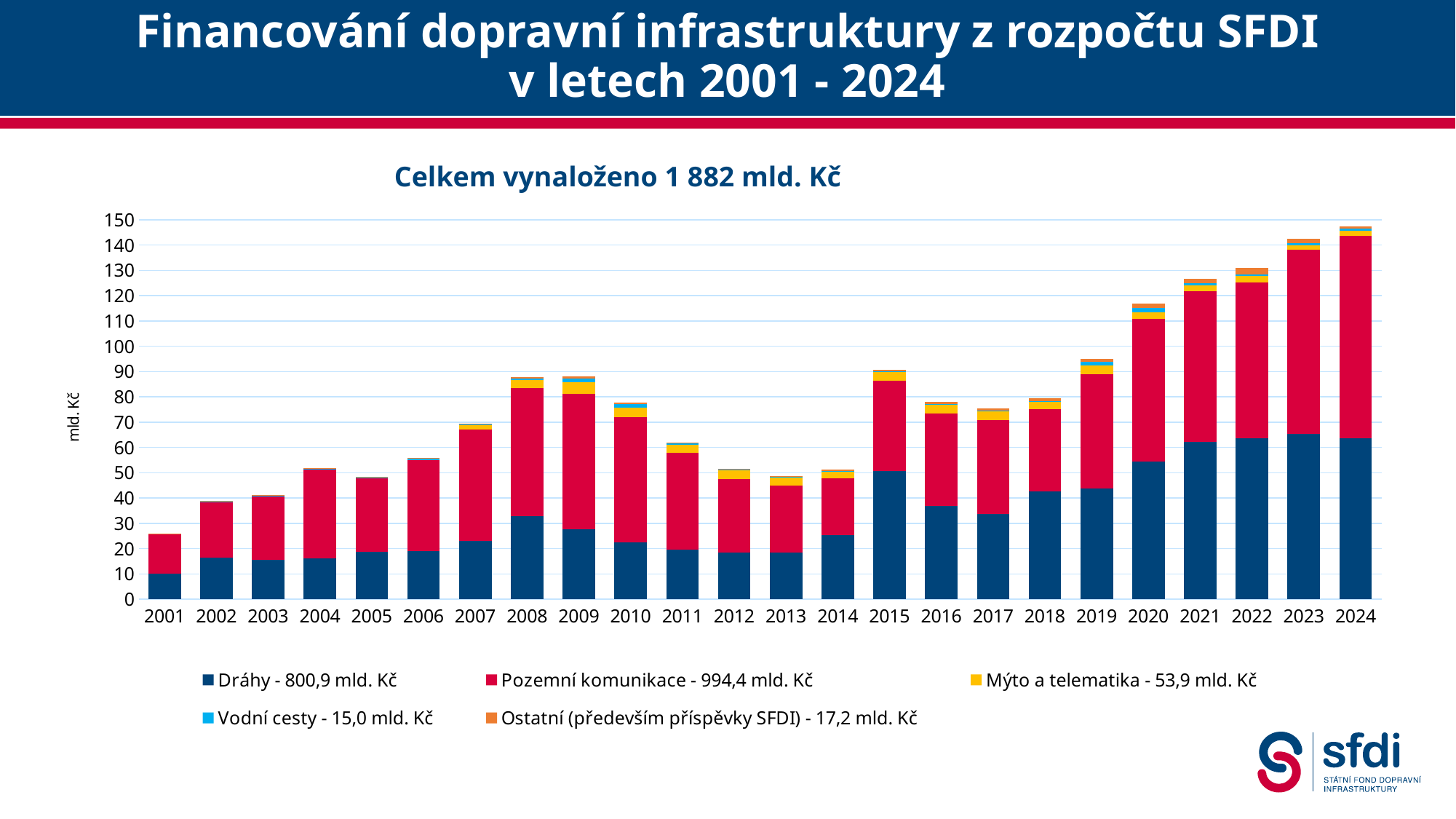
According to the chart subtitle, what is the total amount spent (Celkem vynaloženo)? 1 882 mld. Kč Is the total value for 2016 greater or less than 80? less Which year has the highest total stacked bar? 2024 Is the total value for 2024 greater or less than 140? greater How many series does the chart legend list? 5 How many years (categories) are shown on the x axis of the chart? 24 Which year has a larger total bar, 2015 or 2016? 2015 Do the total bar values generally rise or fall from 2019 to 2024? rise Is the total value for 2001 greater or less than 30? less Which year has the lowest total stacked bar? 2001 What type of chart is shown on the slide? Stacked bar chart